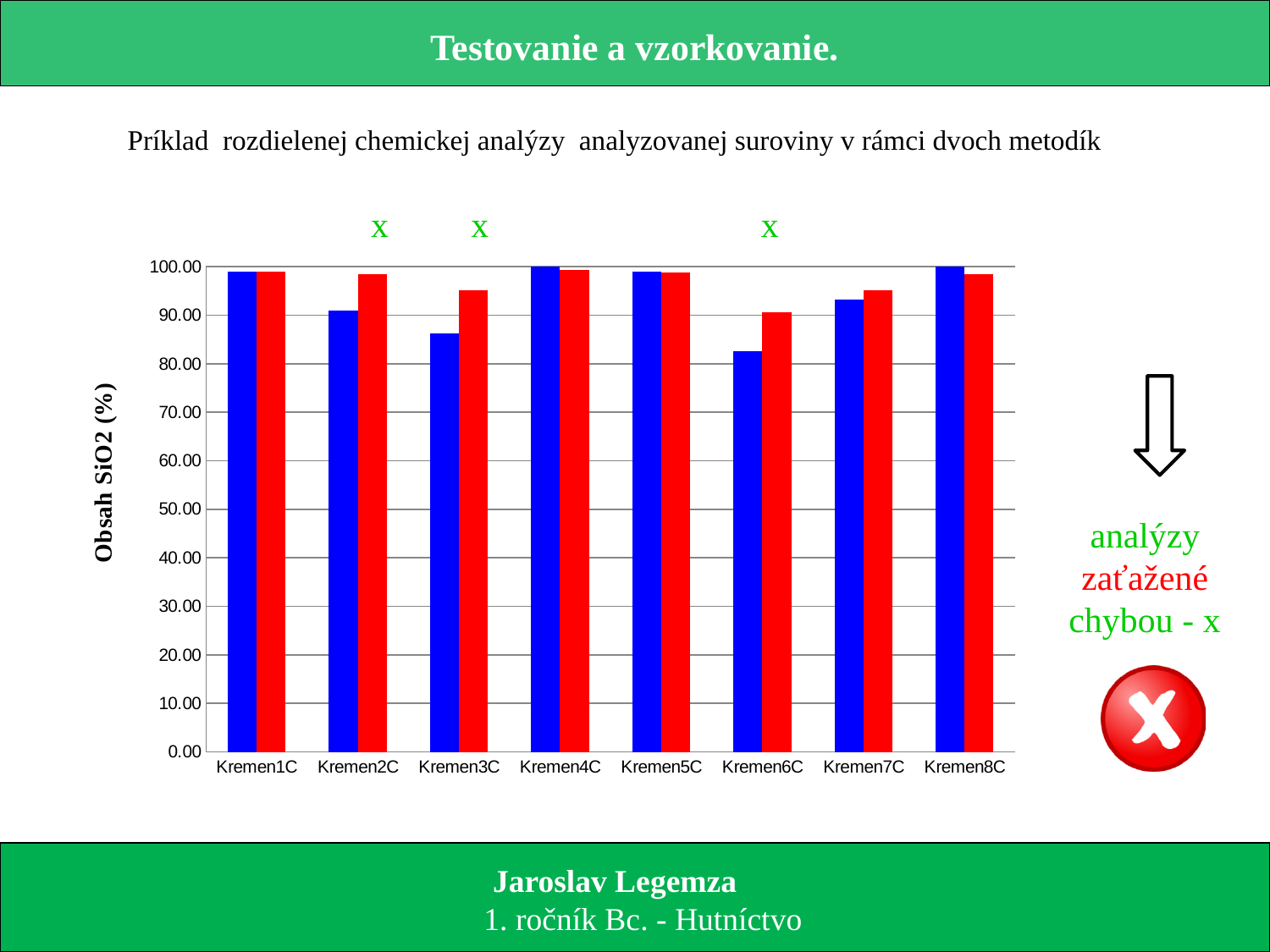
What two colours are used for the bars in the chart? blue and red Which category has the lowest blue bar? Kremen6C Is the value of the blue bar for Kremen6C greater or less than 90.00? less For Kremen6C, which bar is taller, the blue one or the red one? the red one What is the title of the y axis of the chart? Obsah SiO2 (%) Is the value of the red bar for Kremen6C greater or less than 80.00? greater Is the value of the red bar for Kremen3C greater or less than 90.00? greater For Kremen3C, which bar is taller, the blue one or the red one? the red one How many categories are shown on the x axis of the chart? 8 What kind of chart is shown on the slide? bar chart